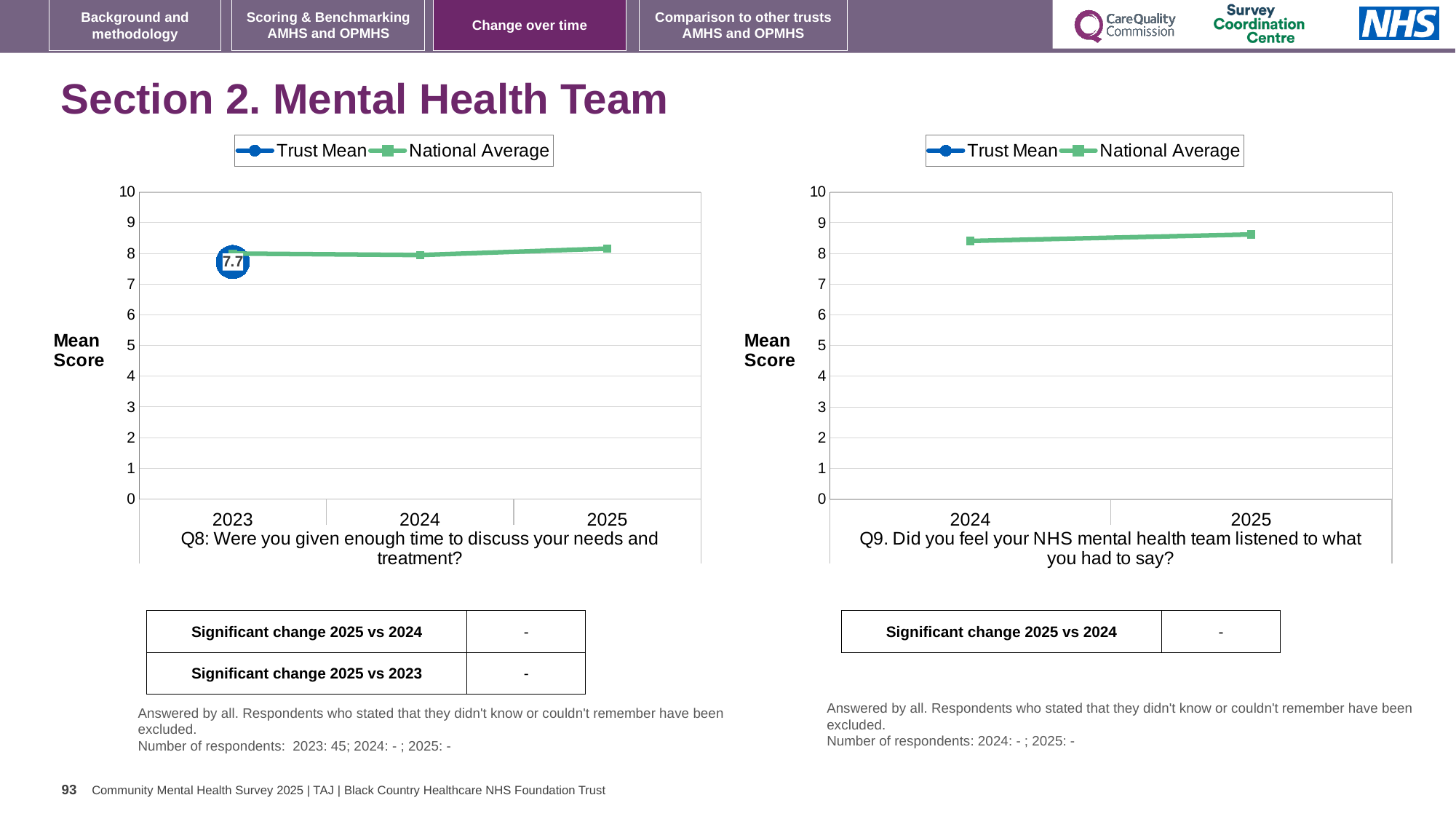
On the right chart (Q9), is the National Average value for 2024 greater or less than 8? greater On the left chart (Q8), what is the Trust Mean value for 2023? 7.7 On the left chart (Q8), is the National Average value for 2024 greater or less than 9? less On the right chart (Q9), does the National Average rise or fall from 2024 to 2025? rise How many years are shown on the x axis of the left chart (Q8)? 3 How many series does the legend of the right chart (Q9) list? 2 What are the two legend entries on the right chart (Q9)? Trust Mean and National Average How many years are shown on the x axis of the right chart (Q9)? 2 What kind of chart is the left chart (Q8)? line chart On the left chart (Q8), is the National Average value for 2025 greater or less than 7? greater What is the y-axis label on the left chart (Q8)? Mean Score